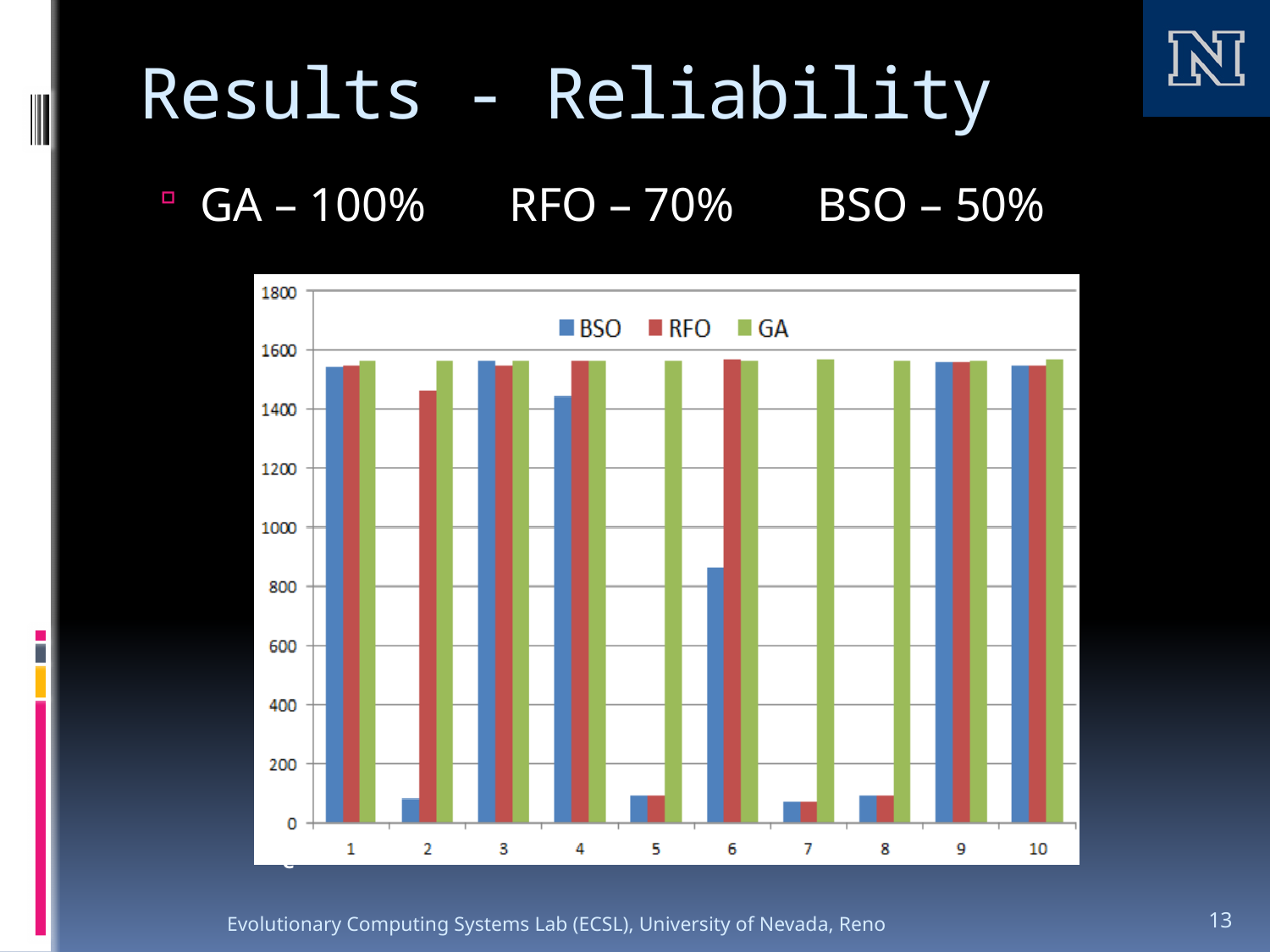
Is the BSO value for category 4 greater or less than 1200? greater Is the RFO value for category 7 greater or less than 200? less How many categories are shown along the x axis of the chart? 10 Which series are listed in the chart's legend? BSO, RFO, GA Is the BSO value for category 6 greater or less than 1000? less What kind of chart is shown on the slide? bar chart What colour are the GA bars in the chart? green For category 6, which is larger, the RFO value or the BSO value? RFO For category 2, which is larger, the GA value or the BSO value? GA How many series does the chart's legend list? 3